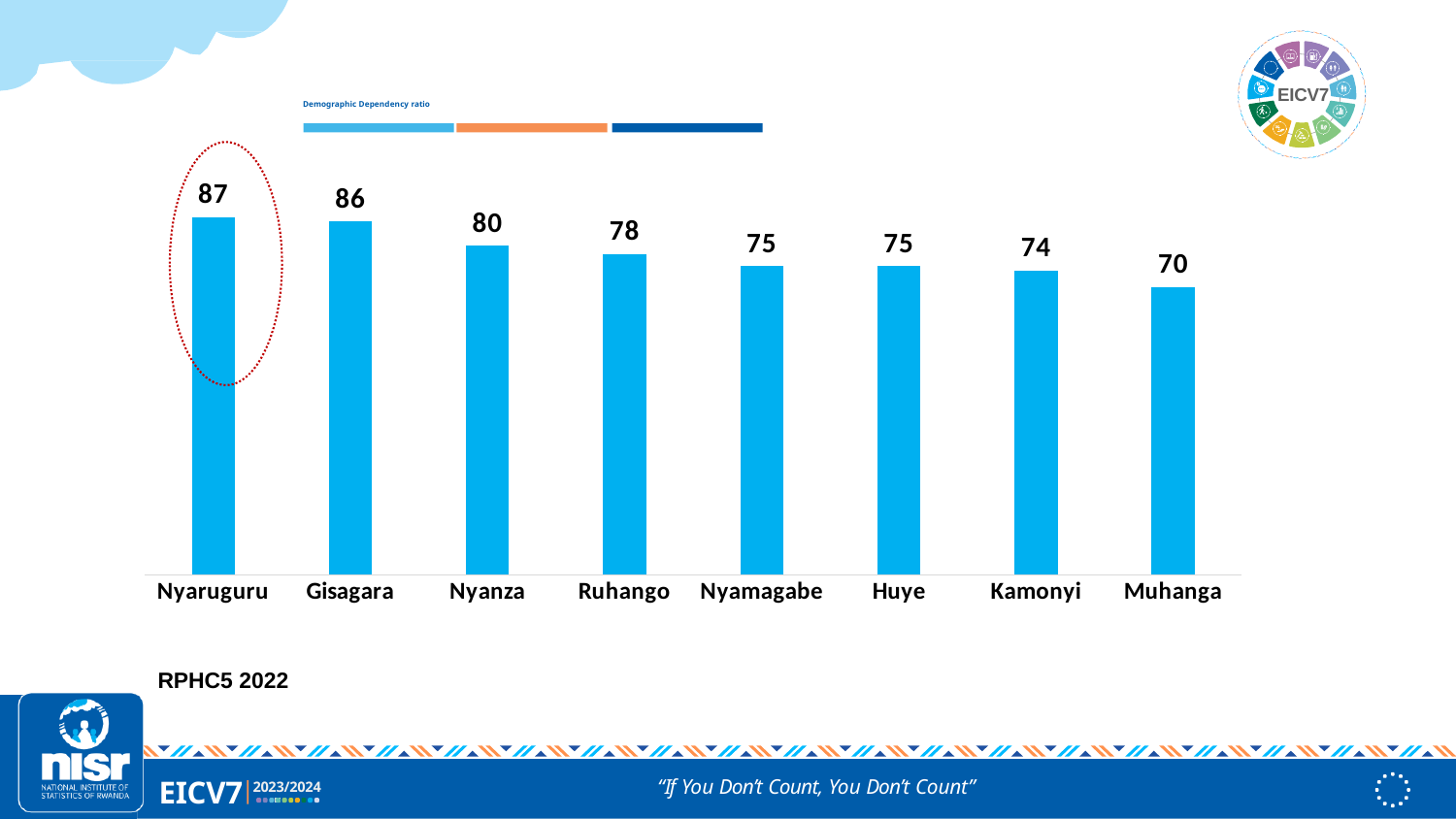
What is the value shown for Kamonyi? 74 Which district has the lowest demographic dependency ratio? Muhanga What is the difference between the values for Nyaruguru and Muhanga? 17 What is the difference between the values for Nyanza and Ruhango? 2 Which district has the highest demographic dependency ratio? Nyaruguru Do the values rise or fall from left to right across the districts? Fall What is the demographic dependency ratio for Muhanga? 70 What is the demographic dependency ratio for Nyaruguru? 87 How many districts are shown in the chart? 8 What is the value shown for Nyanza? 80 What type of chart is shown on the slide? Bar chart Which has a higher value, Gisagara or Nyanza? Gisagara